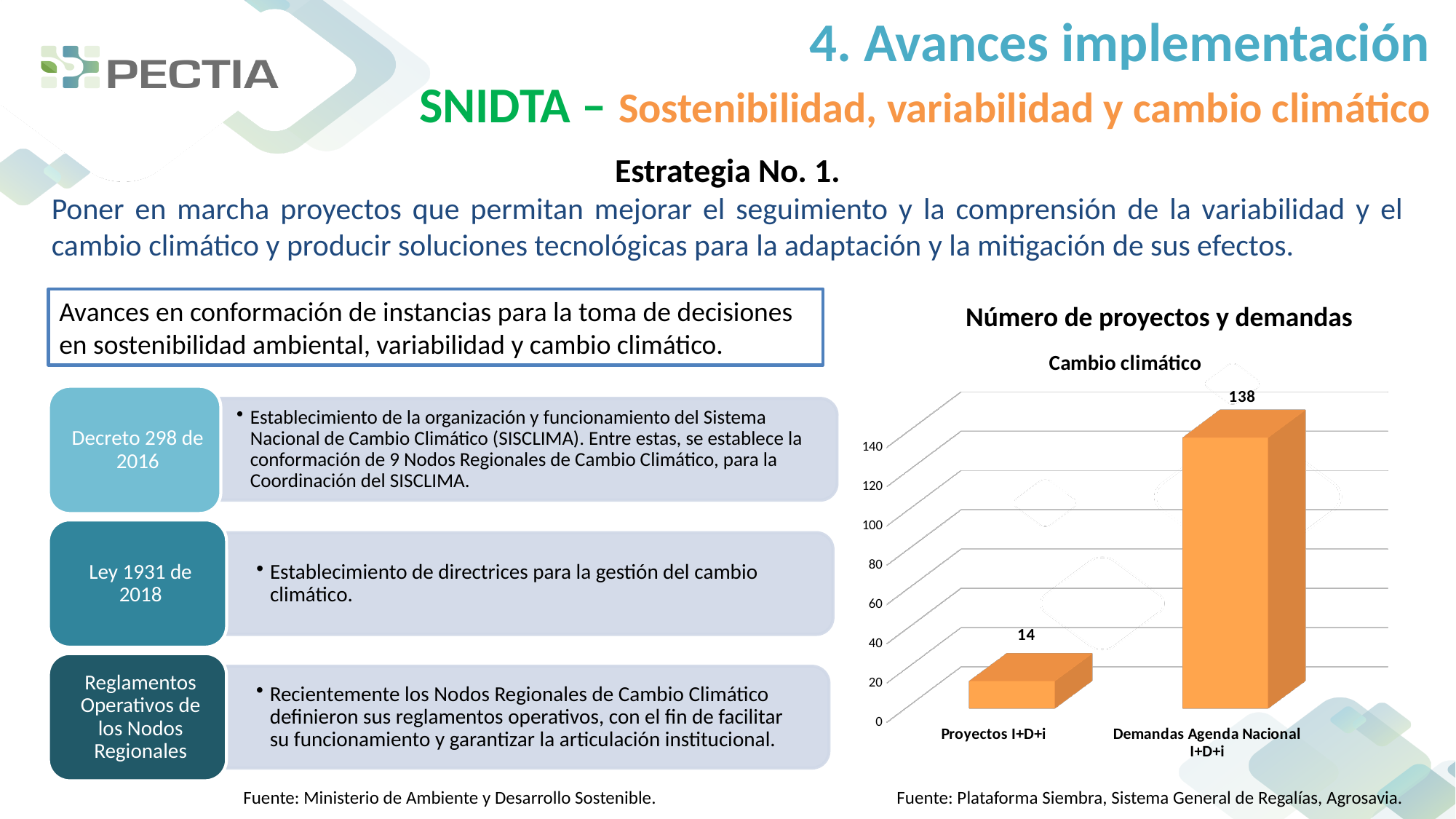
What is the value for Proyectos I+D+i in the chart? 14 Which category has the lowest value in the chart? Proyectos I+D+i Which category has the highest value in the chart? Demandas Agenda Nacional I+D+i Is the value for Demandas Agenda Nacional I+D+i greater or less than 120? greater Is the value for Proyectos I+D+i greater or less than 20? less How many categories are shown in the chart? 2 What kind of chart is shown on the slide? Bar chart What is the difference between the values for Demandas Agenda Nacional I+D+i and Proyectos I+D+i? 124 Which is larger: the value for Proyectos I+D+i or the value for Demandas Agenda Nacional I+D+i? Demandas Agenda Nacional I+D+i What is the value for Demandas Agenda Nacional I+D+i in the chart? 138 What is the subtitle shown above the bars in the chart? Cambio climático What is the title of the chart? Número de proyectos y demandas